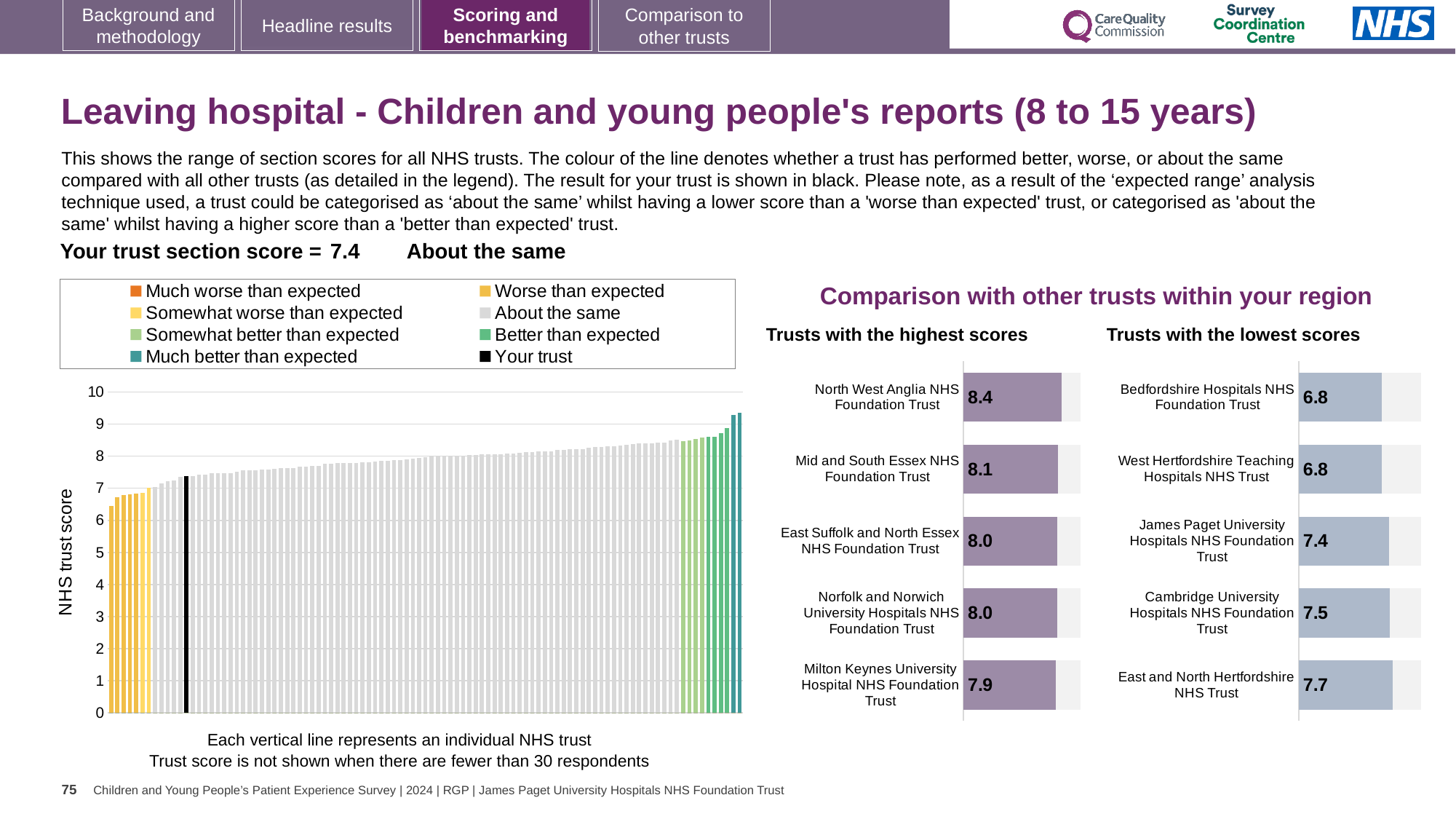
In the 'Trusts with the lowest scores' chart, which trust has the highest score? East and North Hertfordshire NHS Trust What kind of chart is the large chart on the left showing NHS trust scores? Bar chart In the 'Trusts with the highest scores' chart, what is the score for North West Anglia NHS Foundation Trust? 8.4 In the 'Trusts with the lowest scores' chart, what is the score for James Paget University Hospitals NHS Foundation Trust? 7.4 In the 'Trusts with the highest scores' chart, what is the score for Milton Keynes University Hospital NHS Foundation Trust? 7.9 In the 'Trusts with the highest scores' chart, which trust has the highest score? North West Anglia NHS Foundation Trust In the 'Trusts with the lowest scores' chart, which has the larger score: Cambridge University Hospitals NHS Foundation Trust or Bedfordshire Hospitals NHS Foundation Trust? Cambridge University Hospitals NHS Foundation Trust How many entries does the legend of the large chart on the left list? 8 In the large chart on the left, do the trust scores rise or fall from left to right along the x axis? Rise In the 'Trusts with the lowest scores' chart, what is the difference between the scores of East and North Hertfordshire NHS Trust and Bedfordshire Hospitals NHS Foundation Trust? 0.9 In the 'Trusts with the highest scores' chart, what is the difference between the scores of North West Anglia NHS Foundation Trust and Milton Keynes University Hospital NHS Foundation Trust? 0.5 How many trusts are shown in the 'Trusts with the lowest scores' chart? 5